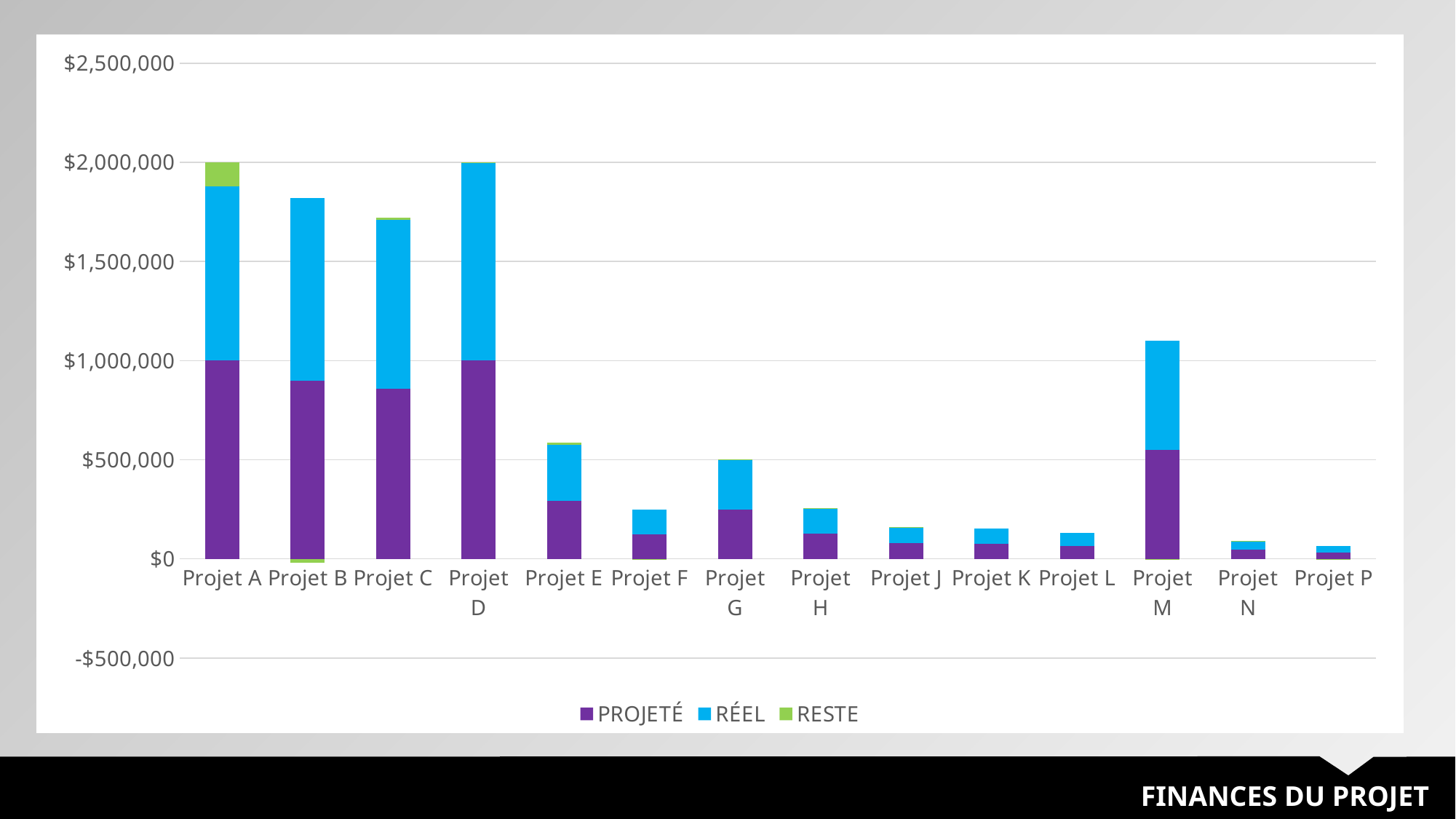
Is the total bar for Projet B greater or less than $1,500,000? greater What kind of chart is shown on the slide? Stacked bar chart Is the total bar for Projet E greater or less than $500,000? greater What are the three series named in the legend? PROJETÉ, RÉEL, RESTE How many projects (categories) are plotted on the x axis? 14 Is the total bar for Projet M greater or less than $1,000,000? greater What is the title shown at the bottom right of the slide? FINANCES DU PROJET Which has the larger total bar, Projet M or Projet E? Projet M Which project has the lowest total bar? Projet P How many series does the legend list? 3 Which has the larger total bar, Projet B or Projet C? Projet B